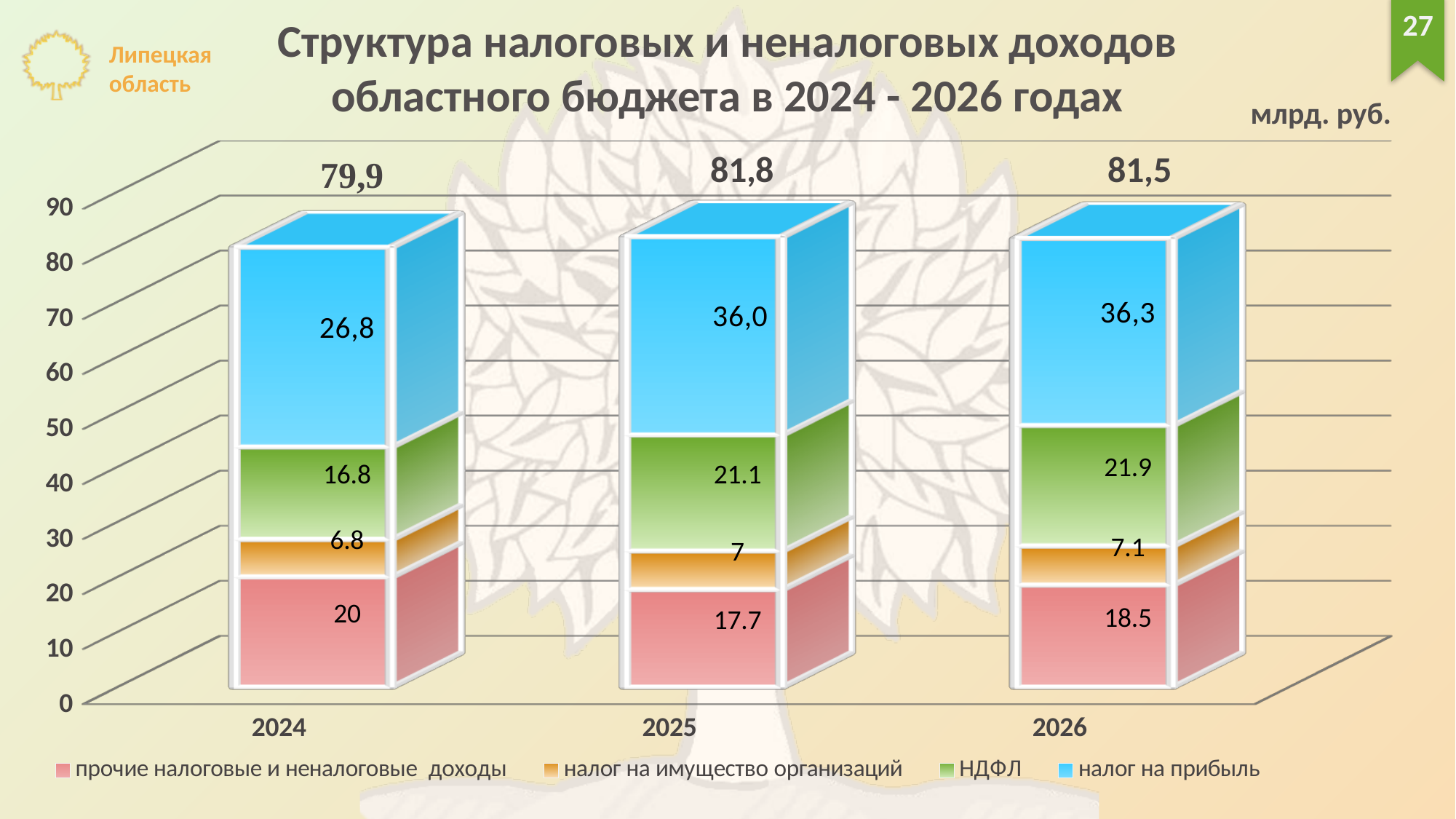
What is the total of the stacked bar for 2024? 79,9 What is the value of прочие налоговые и неналоговые доходы for 2025? 17.7 What type of chart is shown on the slide? stacked bar chart What is the value of налог на прибыль for 2025? 36,0 Which is larger: прочие налоговые и неналоговые доходы in 2024 or in 2026? 2024 How many series does the legend list? 4 What is the value of налог на имущество организаций for 2026? 7.1 What is the difference between the НДФЛ values for 2026 and 2024? 5.1 What is the value of НДФЛ for 2024? 16.8 How many years (categories) are shown on the x axis? 3 Which year has the highest total of tax and non-tax revenues? 2025